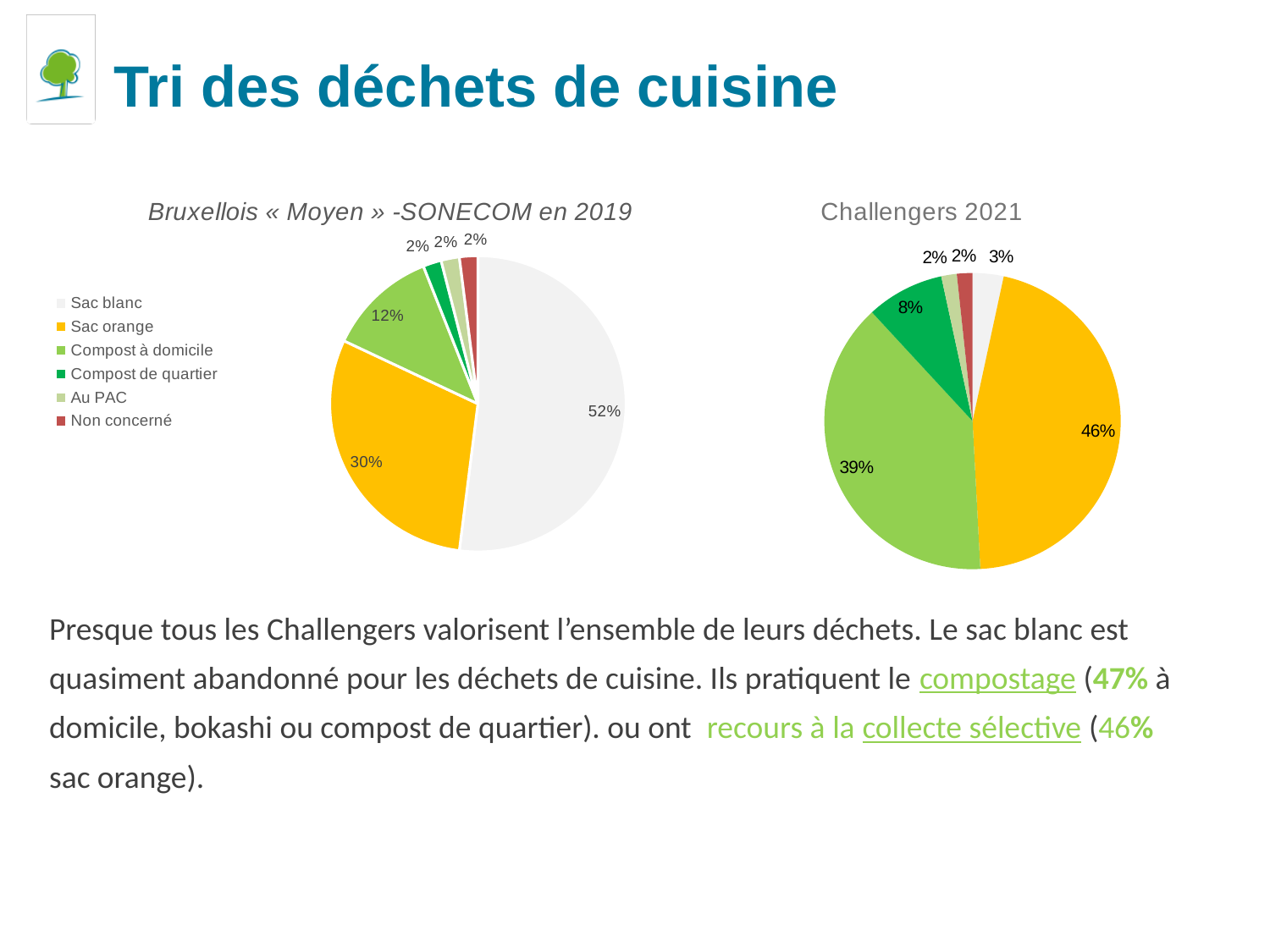
Which is larger: Compost à domicile in the 'Challengers 2021' chart or Compost à domicile in the 'Bruxellois « Moyen » -SONECOM en 2019' chart? Challengers 2021 What type of chart is used on this slide? Pie chart In the 'Bruxellois « Moyen » -SONECOM en 2019' pie chart, what share is Sac orange? 30% How many categories does the legend list for the pie charts? 6 In the 'Bruxellois « Moyen » -SONECOM en 2019' pie chart, what share is Sac blanc? 52% In the 'Challengers 2021' pie chart, which category has the largest slice? Sac orange In the 'Challengers 2021' pie chart, what share is Compost de quartier? 8% What is the difference between the Sac blanc share in the 'Bruxellois « Moyen » -SONECOM en 2019' chart and the Sac orange share in the same chart? 22% In the 'Challengers 2021' pie chart, what share is Sac orange? 46% In the 'Bruxellois « Moyen » -SONECOM en 2019' pie chart, which category has the largest slice? Sac blanc In the 'Bruxellois « Moyen » -SONECOM en 2019' pie chart, what share is Compost à domicile? 12% In the 'Challengers 2021' pie chart, what share is Compost à domicile? 39%